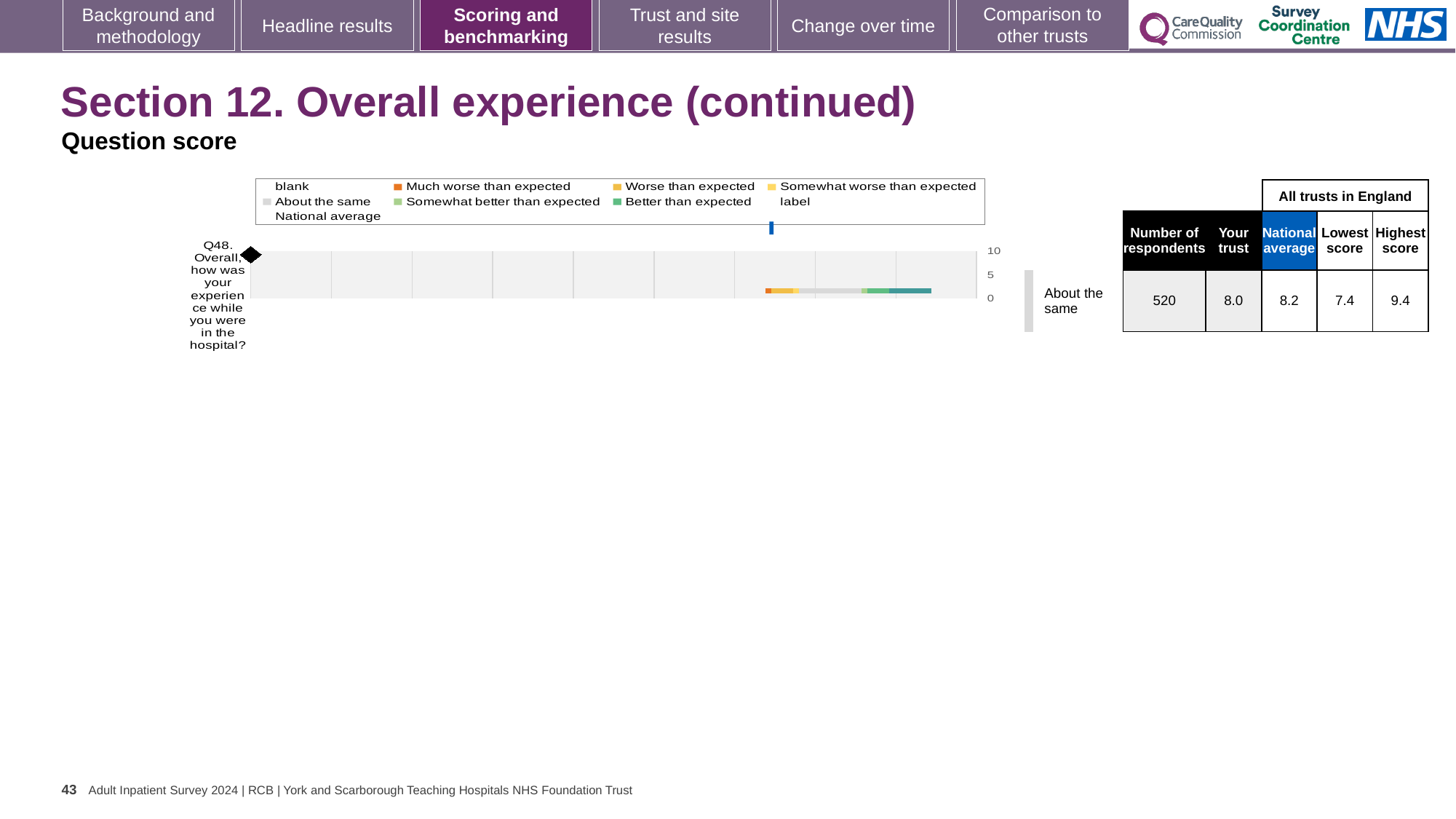
What is the 'Your trust' score for Q48? 8.0 What is the lowest score among all trusts in England for Q48? 7.4 What is the difference between the highest score and the lowest score for Q48? 2.0 What is the highest tick value shown on the chart's axis? 10 How many questions (categories) are plotted in the chart? 1 What is the national average score for Q48? 8.2 What is the highest score among all trusts in England for Q48? 9.4 How many respondents answered Q48? 520 How many entries does the chart legend list? 9 What kind of chart is shown on the slide? bar chart Which is larger for Q48, the 'Your trust' score or the national average? National average Which question is plotted in the chart? Q48. Overall, how was your experience while you were in the hospital?